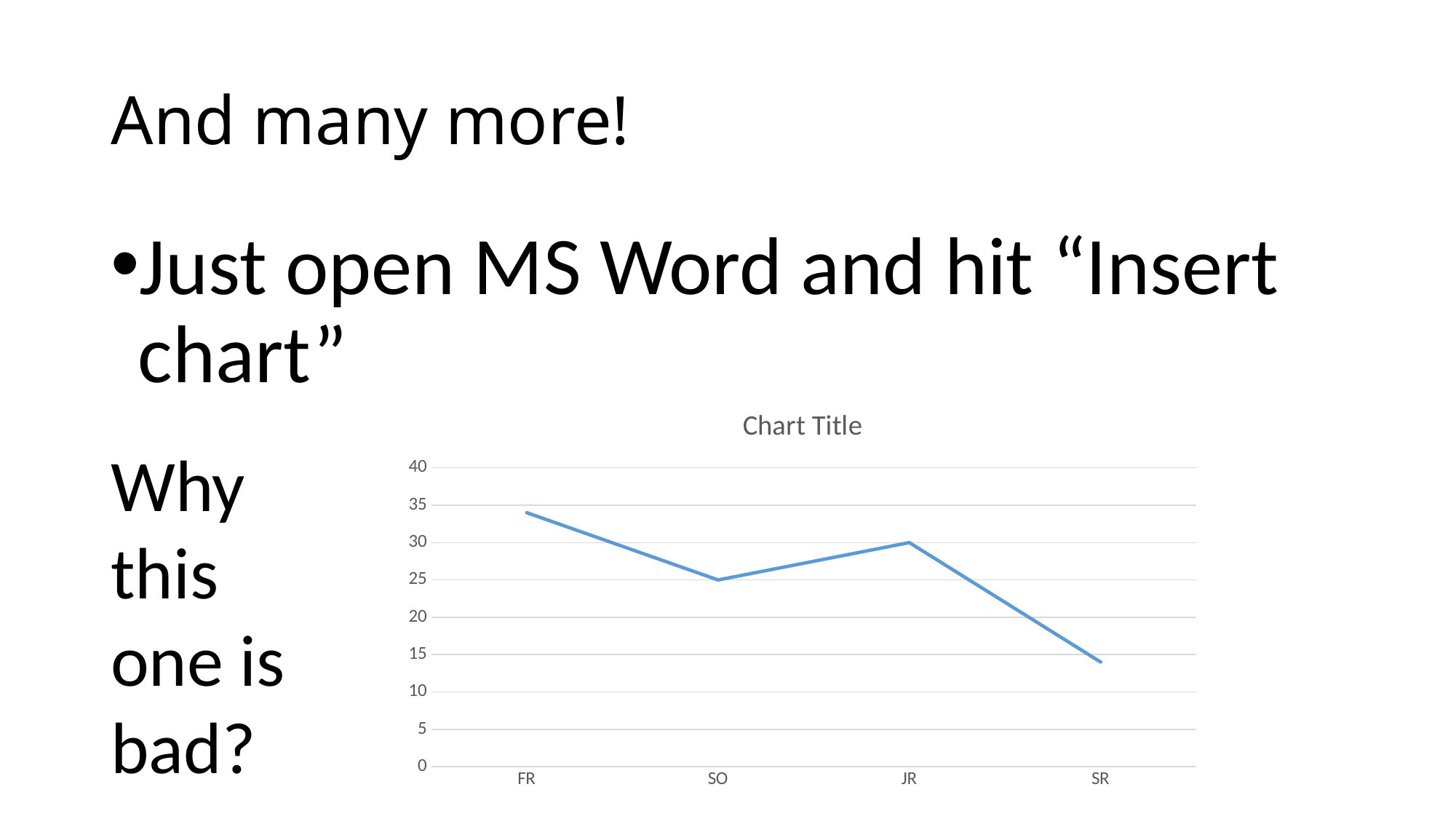
How many categories are plotted along the x axis? 4 What is the value for JR? 30 Which is larger, the value for FR or the value for SO? FR Which category has the lowest value? SR What is the title of the chart? Chart Title What is the value for SO? 25 Does the line overall rise or fall from FR to SR? fall What type of chart is shown on the slide? line chart Is the value for SR greater or less than 20? less What is the difference between the values for JR and SO? 5 Which category has the highest value? FR Is the value for FR greater or less than 30? greater